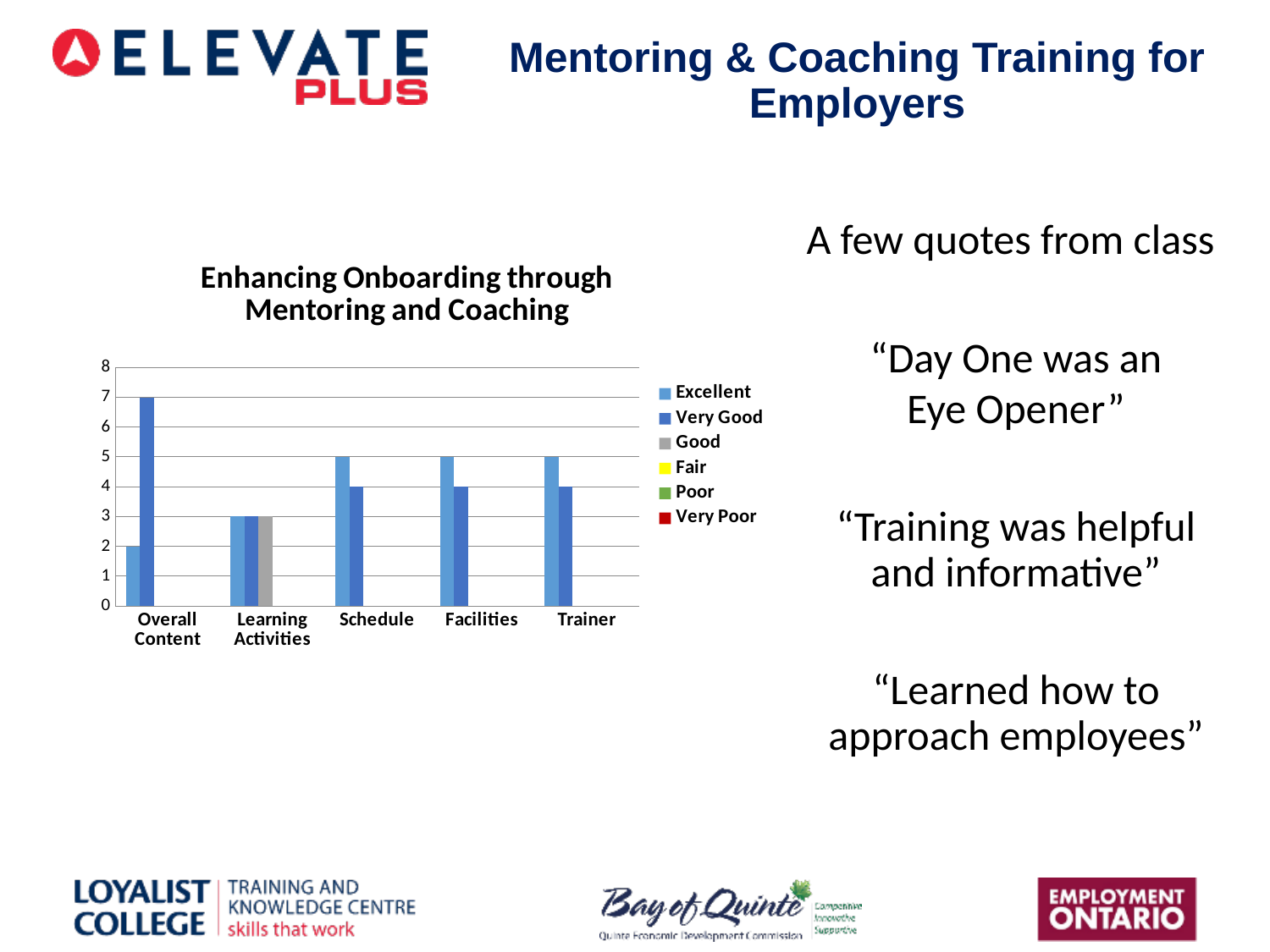
Which category has the lowest Excellent value? Overall Content What is the Excellent value for Overall Content? 2 Which category has the highest Very Good value? Overall Content How many categories are shown on the x axis of the chart? 5 What is the difference between the Very Good and Excellent values for Overall Content? 5 What is the Good value for Learning Activities? 3 What is the title of the chart? Enhancing Onboarding through Mentoring and Coaching How many series does the chart's legend list? 6 What is the Very Good value for Overall Content? 7 What kind of chart is shown on the slide? bar chart What is the Excellent value for Trainer? 5 For Schedule, which is larger, the Excellent value or the Very Good value? Excellent